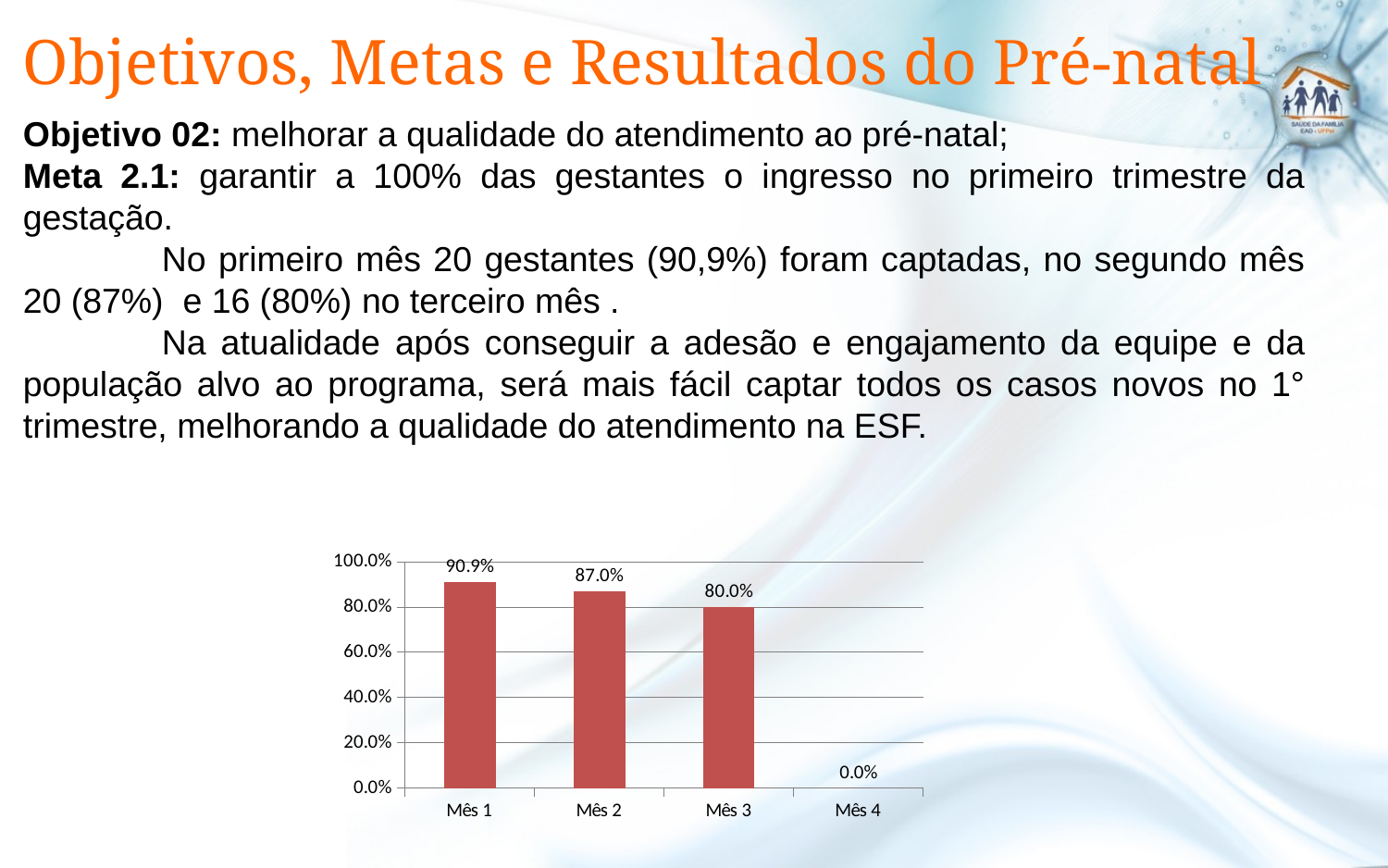
What is the value for Mês 4? 0.0% Which category has the lowest value? Mês 4 Do the values rise or fall from Mês 1 to Mês 4? Fall What is the difference between the values for Mês 2 and Mês 3? 7.0% How many categories are shown on the x axis? 4 What is the value for Mês 1? 90.9% What kind of chart is shown on the slide? Bar chart Which category has the highest value? Mês 1 What is the difference between the values for Mês 1 and Mês 3? 10.9% What is the value for Mês 3? 80.0% What is the value for Mês 2? 87.0% Which is larger, the value for Mês 2 or the value for Mês 3? Mês 2